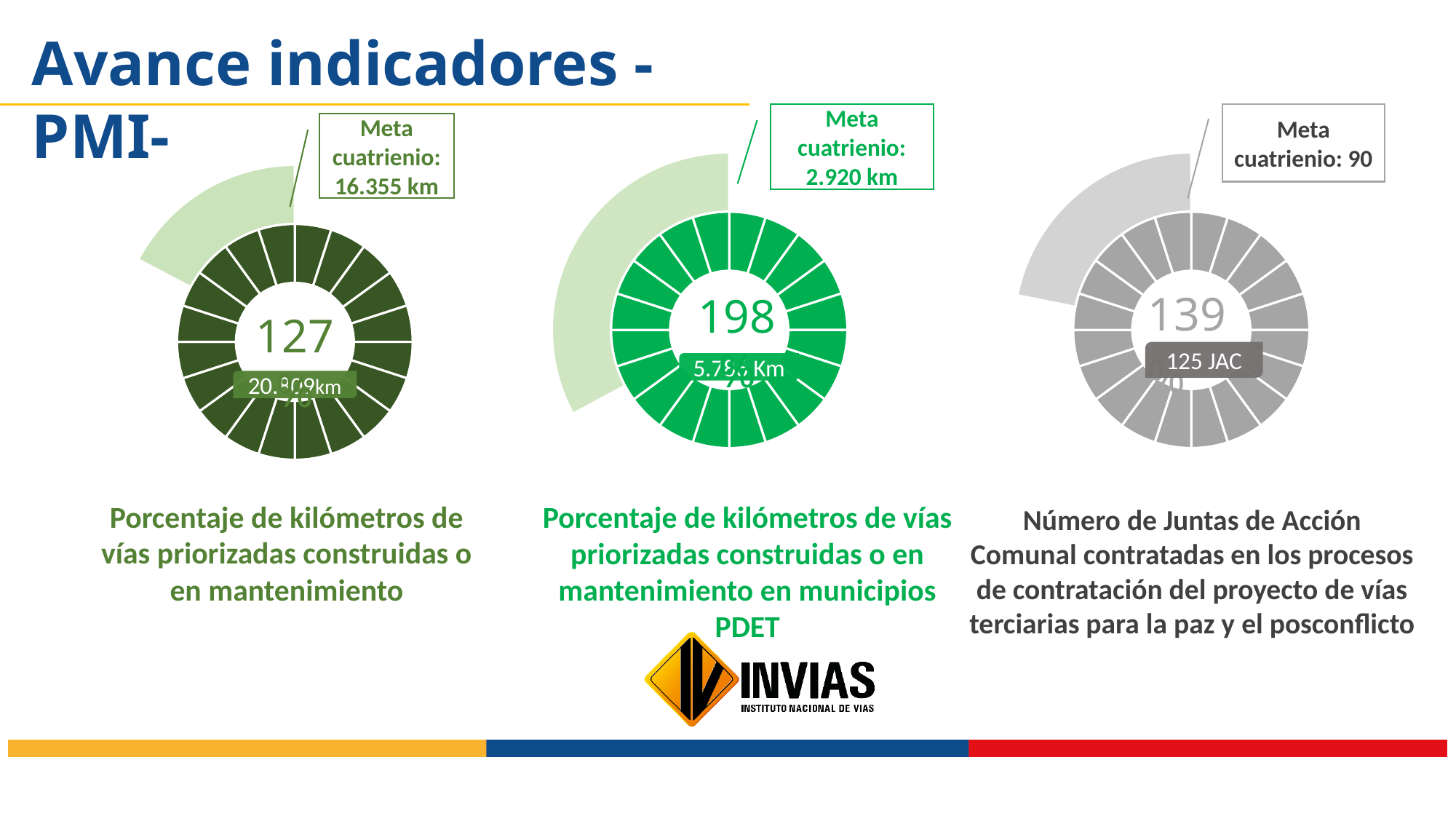
Which of the three charts shows the lowest central number? The left chart (Porcentaje de kilómetros de vías priorizadas construidas o en mantenimiento) What is the difference between the central number of the middle chart (198) and the central number of the left chart (127)? 71 On the middle chart (municipios PDET), what is the 'Meta cuatrienio' value shown in the callout box? 2.920 km How many donut charts are shown on the slide? 3 On the right chart (Juntas de Acción Comunal), what is the 'Meta cuatrienio' value shown in the callout box? 90 On the middle chart (municipios PDET), what number is shown in the centre of the donut? 198 Which of the three charts shows the highest central number? The middle chart (municipios PDET) On the left chart (Porcentaje de kilómetros de vías priorizadas construidas o en mantenimiento), what number is shown in the centre of the donut? 127 Is the central number of the right chart (Juntas de Acción Comunal) larger or smaller than the central number of the left chart? Larger On the left chart, what is the 'Meta cuatrienio' value shown in the callout box? 16.355 km On the right chart (Número de Juntas de Acción Comunal contratadas), what number is shown in the centre of the donut? 139 On the right chart (Juntas de Acción Comunal), what value is shown in the grey label below the central number? 125 JAC